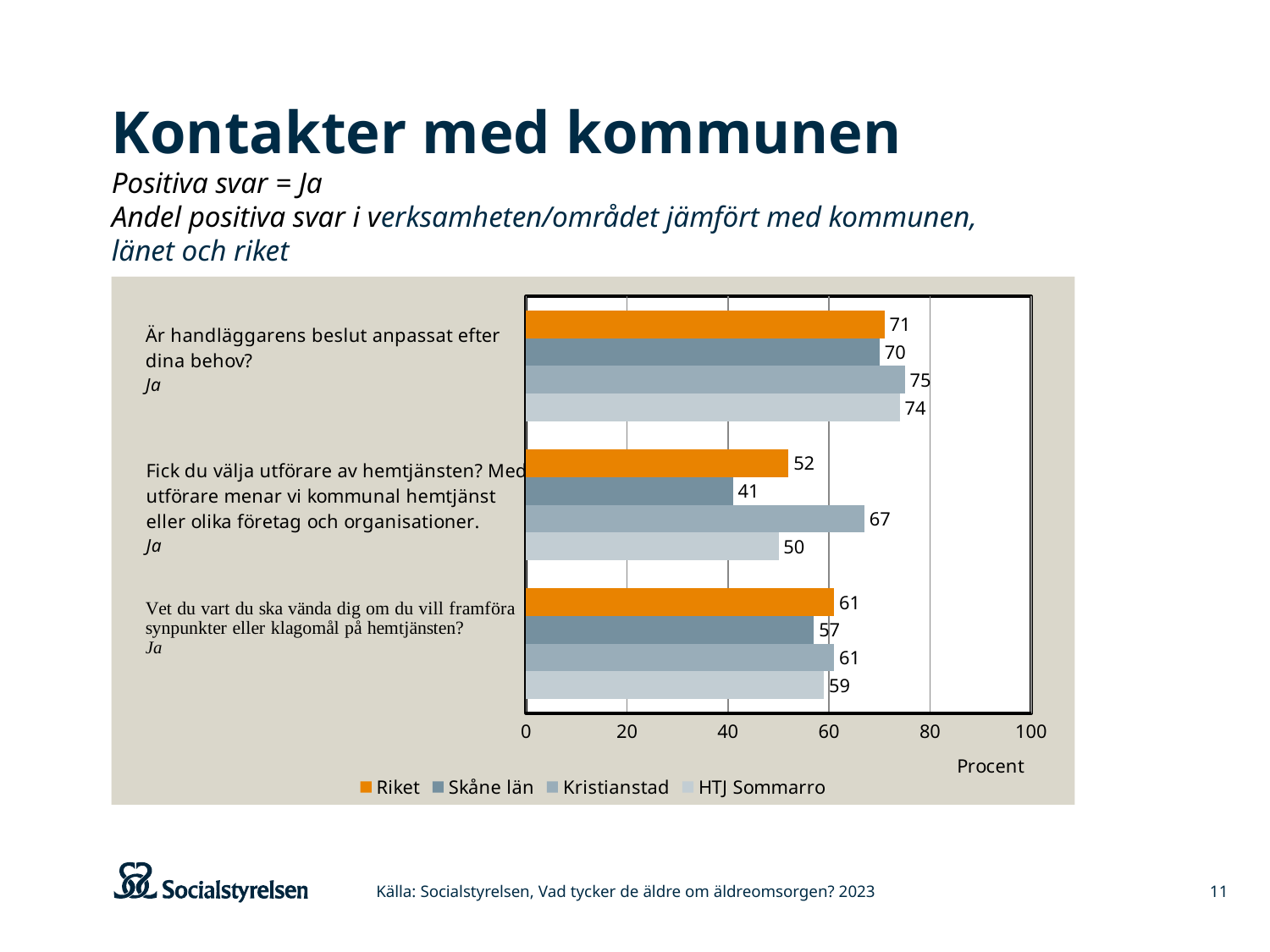
What label is shown on the horizontal axis of the chart? Procent Is the value for HTJ Sommarro on the question "Fick du välja utförare av hemtjänsten?" greater or less than 60? less Which series has the lowest value on the question "Är handläggarens beslut anpassat efter dina behov?"? Skåne län What is the value for HTJ Sommarro on the question "Vet du vart du ska vända dig om du vill framföra synpunkter eller klagomål på hemtjänsten?"? 59 How many series does the legend list? 4 On the question "Vet du vart du ska vända dig om du vill framföra synpunkter eller klagomål på hemtjänsten?", which is larger: Riket or Skåne län? Riket What is the value for Kristianstad on the question "Är handläggarens beslut anpassat efter dina behov?"? 75 How many question categories are plotted on the chart? 3 What kind of chart is shown on the slide? bar chart What is the difference between Kristianstad and Skåne län on the question "Fick du välja utförare av hemtjänsten?"? 26 What is the value for Skåne län on the question "Fick du välja utförare av hemtjänsten?"? 41 Which series has the highest value on the question "Fick du välja utförare av hemtjänsten?"? Kristianstad